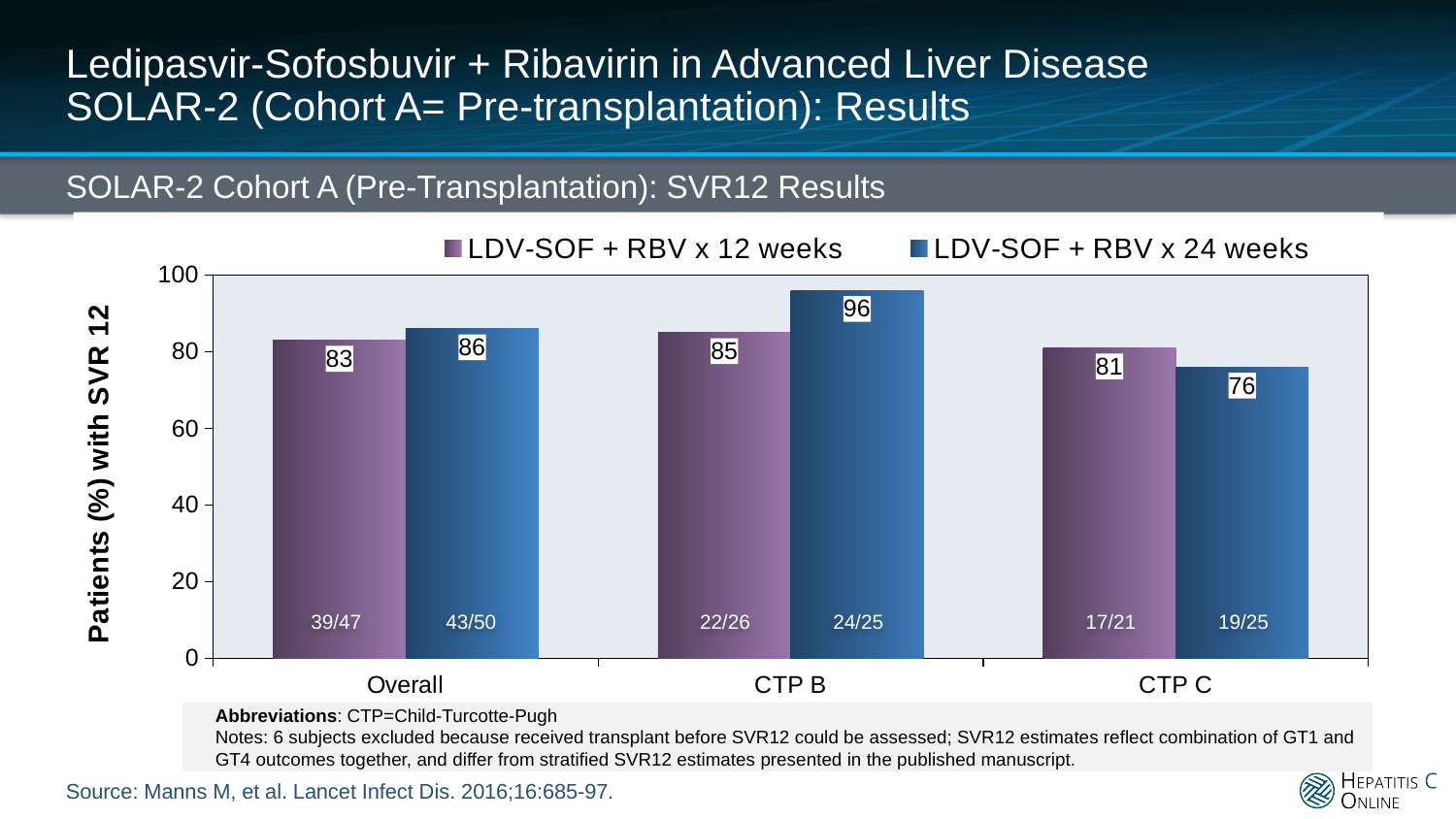
In the CTP C group, which regimen has the higher SVR12 rate, 12 weeks or 24 weeks? LDV-SOF + RBV x 12 weeks What is the label of the y axis? Patients (%) with SVR 12 How many series does the legend list? 2 What is the difference between the 24-week and 12-week SVR12 rates in the CTP B group? 11 What fraction of patients is shown for LDV-SOF + RBV x 12 weeks in the CTP B group? 22/26 What is the SVR12 rate for LDV-SOF + RBV x 24 weeks in the CTP B group? 96 What is the SVR12 rate for LDV-SOF + RBV x 24 weeks in the CTP C group? 76 Which category has the highest SVR12 rate for LDV-SOF + RBV x 24 weeks? CTP B Which category has the lowest SVR12 rate for LDV-SOF + RBV x 24 weeks? CTP C How many categories are shown on the x axis? 3 What is the SVR12 rate for LDV-SOF + RBV x 12 weeks in the Overall group? 83 What kind of chart is shown on the slide? Bar chart